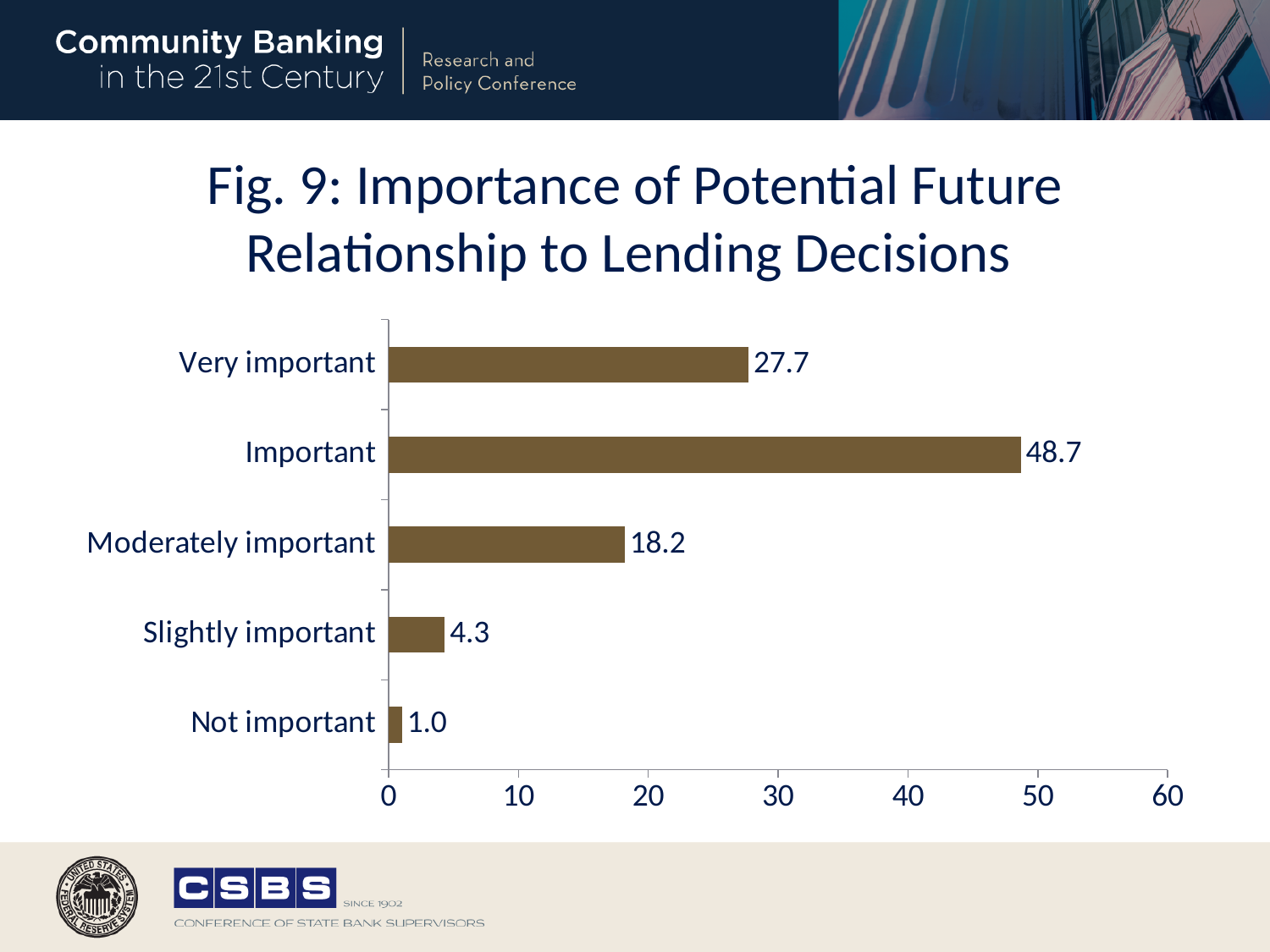
What is the value for Very important? 27.7 Which category has the highest value? Important What kind of chart is shown on the slide? Bar chart What is the title of the chart? Fig. 9: Importance of Potential Future Relationship to Lending Decisions What is the difference between the values for Important and Very important? 21.0 How many categories are shown in the chart? 5 Which category has the lowest value? Not important Which is larger, the value for Moderately important or the value for Slightly important? Moderately important What is the value for Slightly important? 4.3 What is the value for Important? 48.7 What is the value for Not important? 1.0 What is the value for Moderately important? 18.2